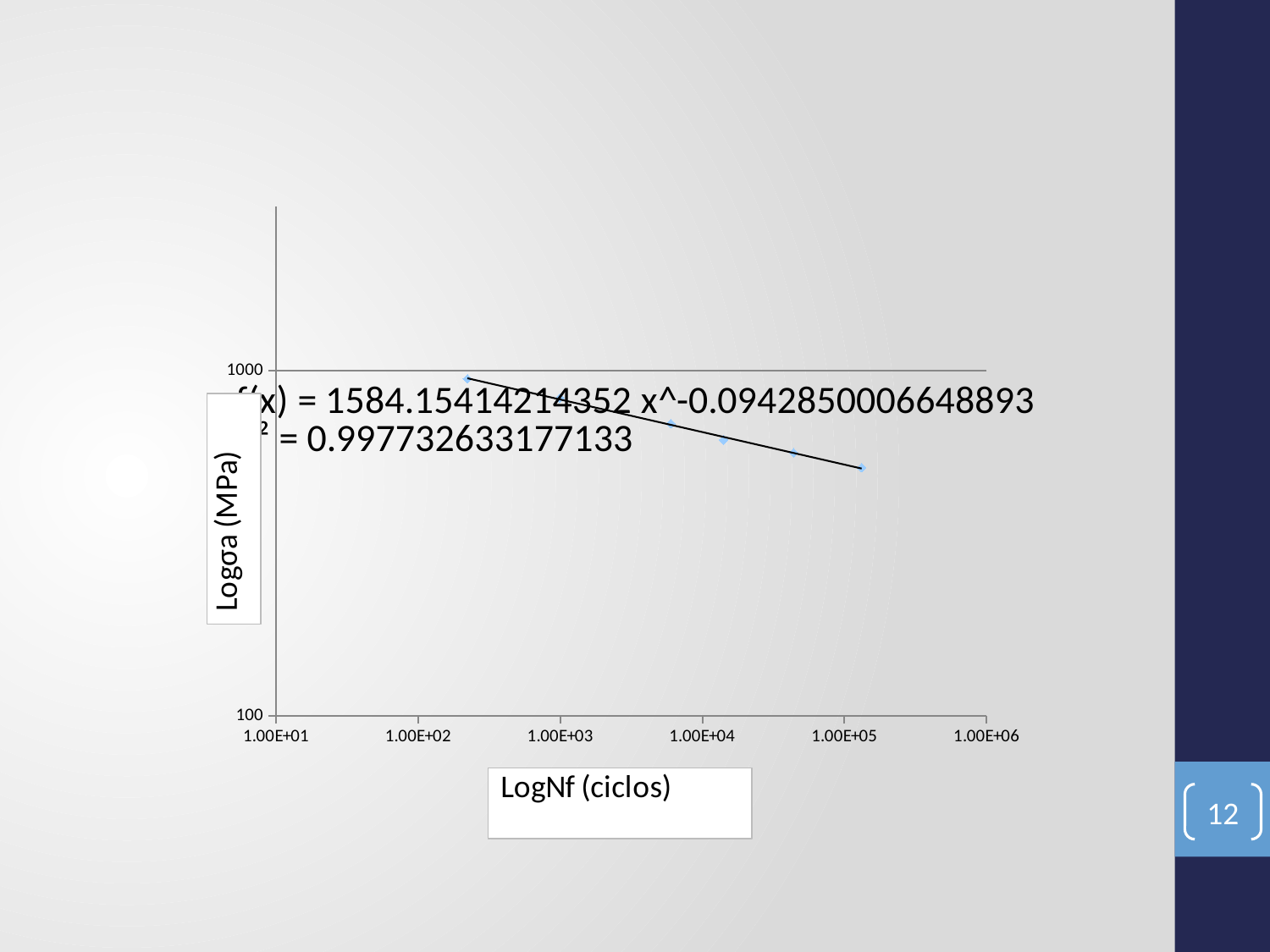
How many data points are plotted on the chart? 6 What R² value is printed on the chart? 0.997732633177133 Is the value for the rightmost data point greater or less than 1000? less Do the plotted values rise or fall as LogNf (ciclos) increases along the x axis? fall Is the value for the leftmost data point greater or less than 1000? less What kind of chart is shown on the slide? scatter chart Which data point is higher, the leftmost one or the rightmost one? the leftmost one Is the value for the leftmost data point greater or less than 100? greater What is the title of the x axis? LogNf (ciclos)